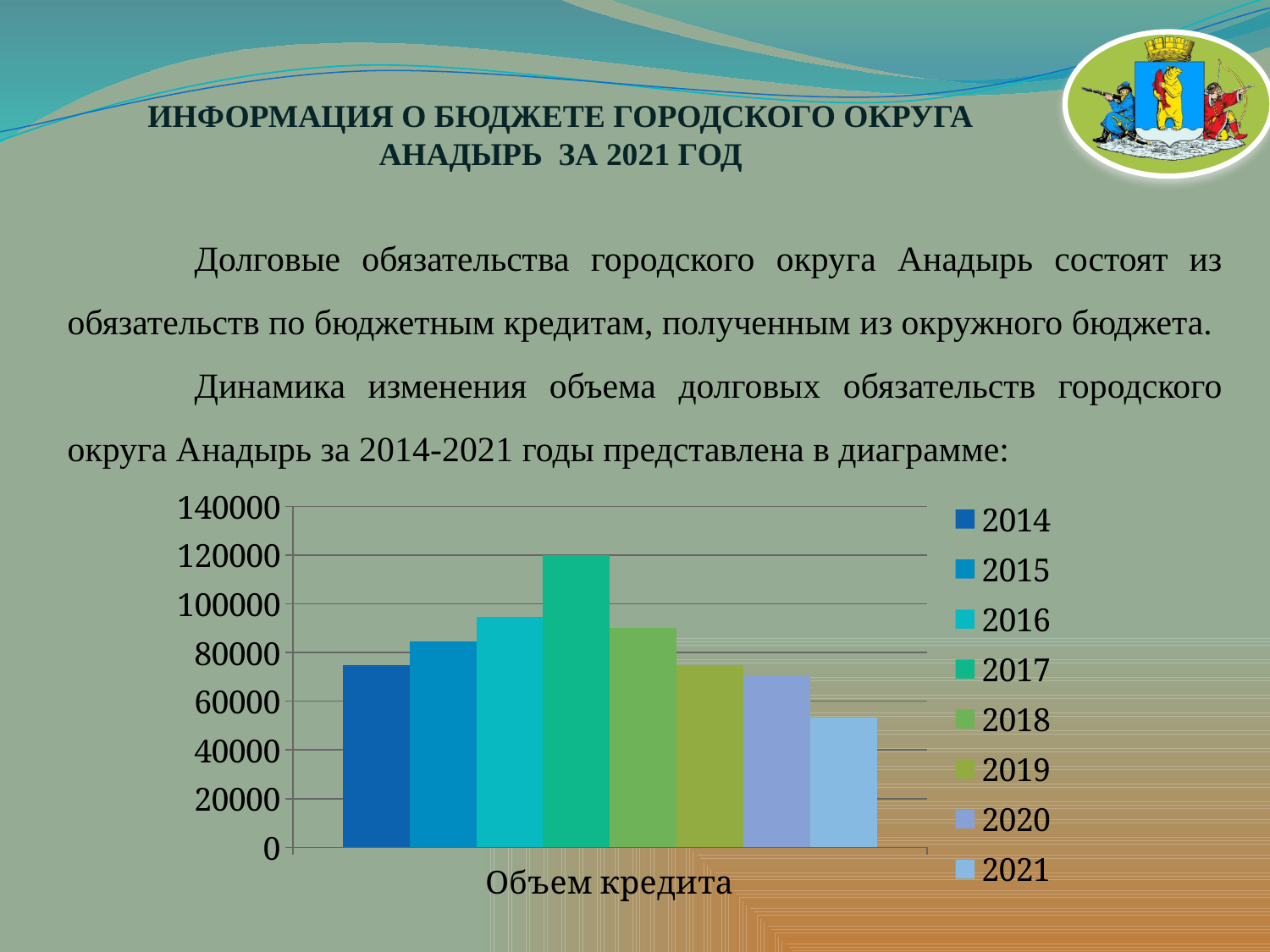
Which is larger, the value for 2018 or the value for 2019? 2018 What kind of chart is shown on the slide? bar chart Which year has the highest bar in the chart? 2017 How many categories are shown on the x axis of the chart? 1 Which year has the lowest bar in the chart? 2021 Is the value for 2014 greater or less than 80000? less Is the value for 2017 greater or less than 100000? greater Is the value for 2021 greater or less than 60000? less How many series does the legend list? 8 What is the category label shown on the x axis of the chart? Объем кредита Which is larger, the value for 2016 or the value for 2015? 2016